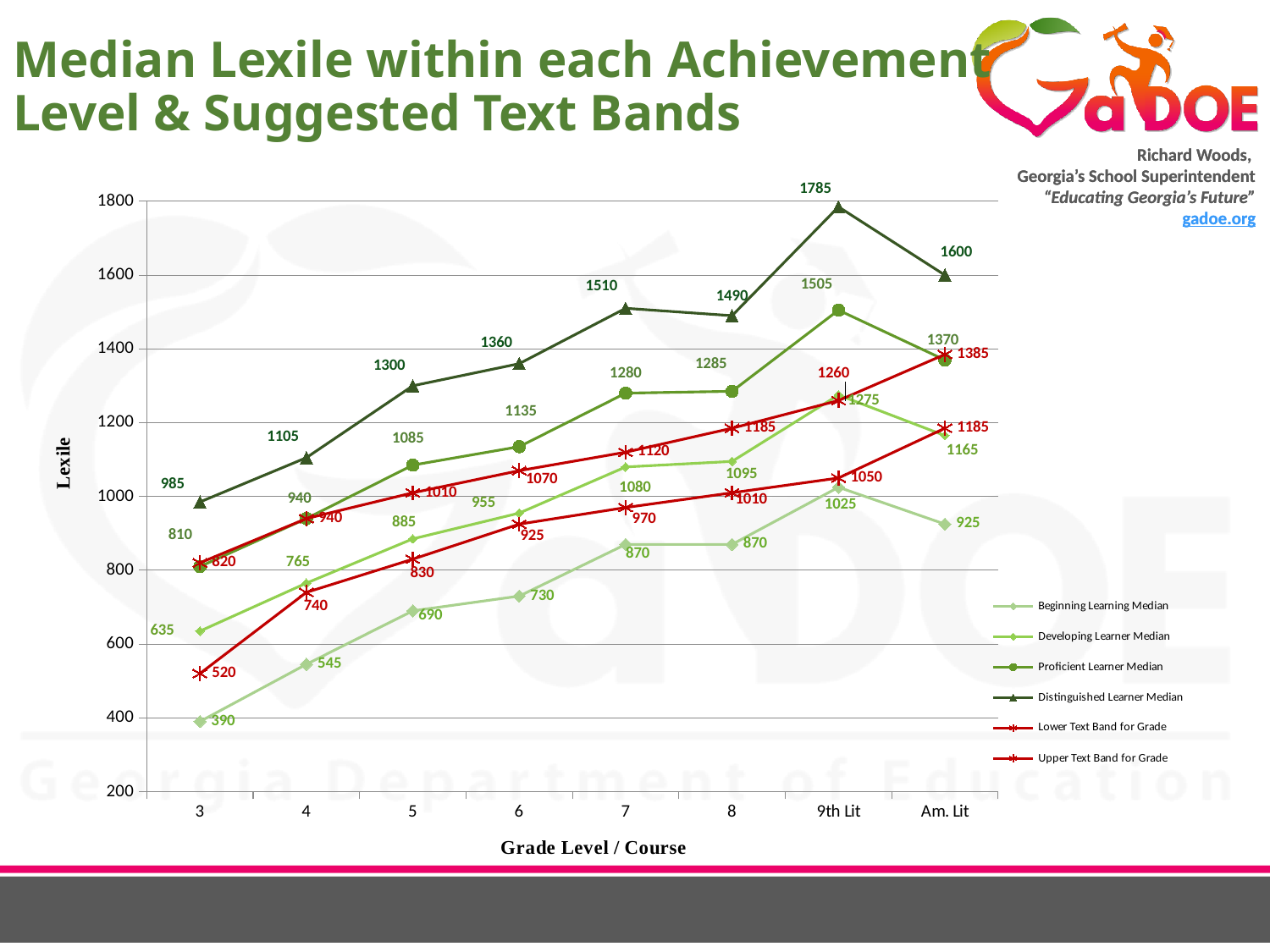
What is the Beginning Learning Median value for grade 3? 390 How many grade levels or courses are shown on the x axis? 8 How many series does the legend list? 6 At which grade level or course is the Beginning Learning Median lowest? 3 What is the title of the vertical axis? Lexile What is the difference between the Distinguished Learner Median at 9th Lit and at Am. Lit? 185 Does the Distinguished Learner Median rise or fall from grade 3 to grade 7? Rise What kind of chart is shown on the slide? Line chart At which grade level or course is the Distinguished Learner Median highest? 9th Lit What is the Distinguished Learner Median value for 9th Lit? 1785 At grade 5, which is larger: the Proficient Learner Median or the Upper Text Band for Grade? Proficient Learner Median What is the Lower Text Band for Grade value at grade 6? 925